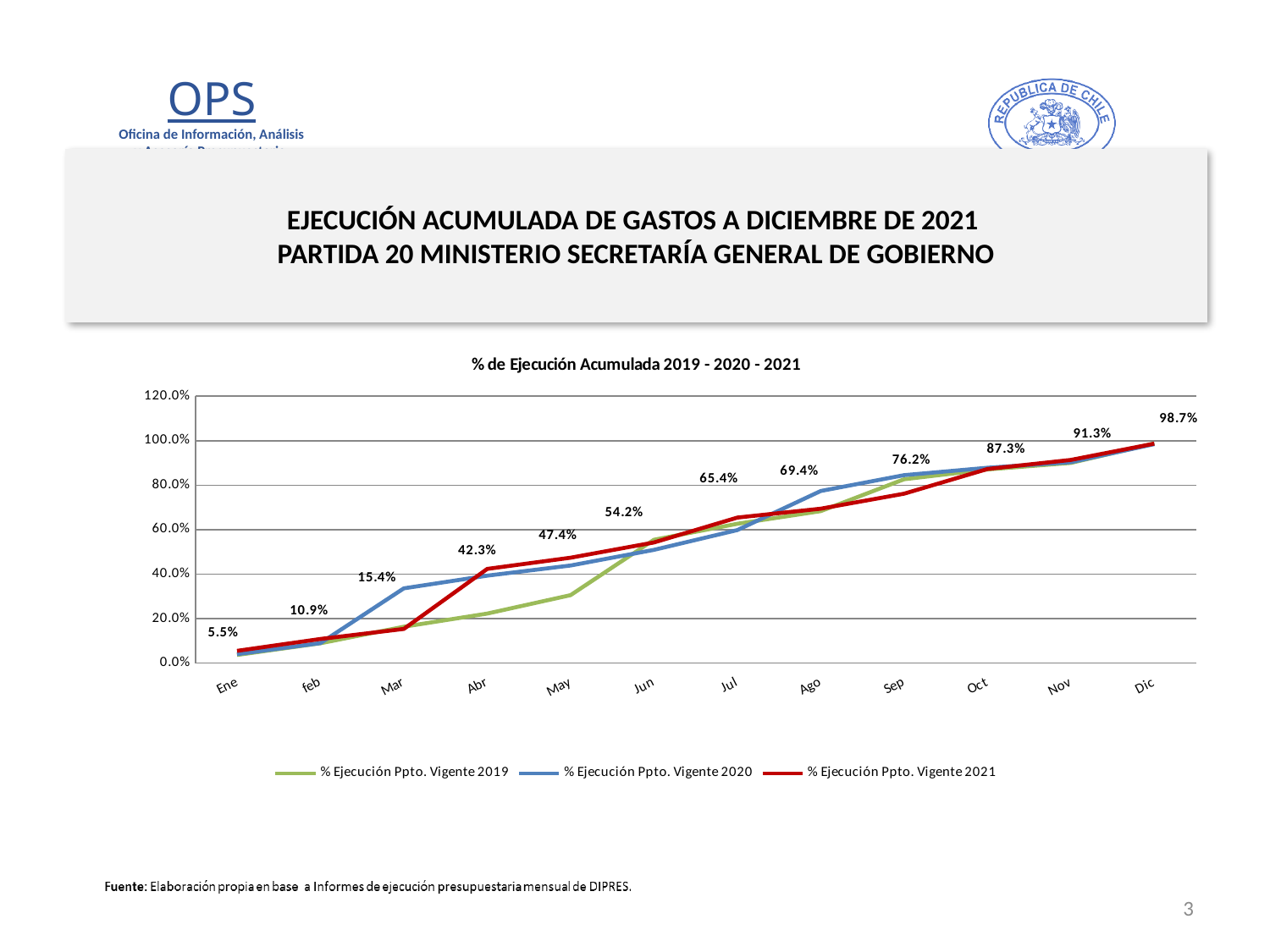
How many series does the legend list? 3 What is the value labelled for the 2021 series in Sep? 76.2% Is the value for the 2020 series (% Ejecución Ppto. Vigente 2020) in Mar greater or less than 20.0%? greater What kind of chart is shown on the slide? line chart How many months are shown on the x axis? 12 What is the value labelled for the 2021 series in Abr? 42.3% What is the difference between the labelled 2021 values for Abr and Mar? 26.9% What is the value labelled for the 2021 series (% Ejecución Ppto. Vigente 2021) in Dic? 98.7% In Mar, which series has the larger value: % Ejecución Ppto. Vigente 2020 or % Ejecución Ppto. Vigente 2019? % Ejecución Ppto. Vigente 2020 What is the title of the chart? % de Ejecución Acumulada 2019 - 2020 - 2021 Do the labelled 2021 values rise or fall from Ene to Dic? rise What is the value labelled for the 2021 series in Ene? 5.5%